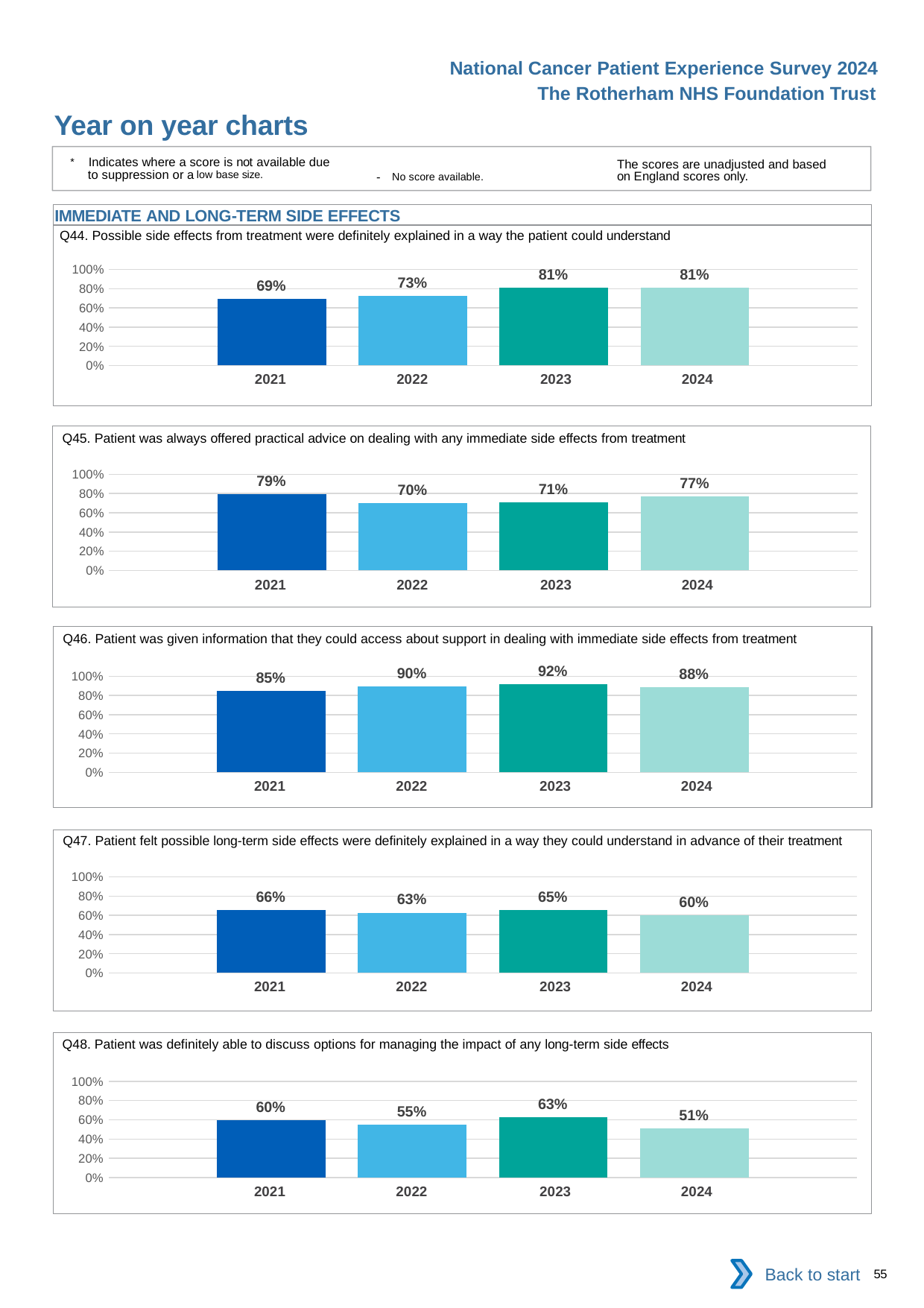
What is the section heading above the Q44 chart? IMMEDIATE AND LONG-TERM SIDE EFFECTS In the Q46 chart, is the value for 2024 greater or less than 80%? greater In the Q48 chart, is the value for 2023 larger or smaller than the value for 2022? larger In the Q45 chart, what is the difference between the 2021 and 2022 values? 9 percentage points What kind of chart is the Q45 chart? bar chart In the Q44 chart, how many years are plotted? 4 In the Q45 chart, which year has the highest value? 2021 In the Q47 chart, which year has the lowest value? 2024 In the Q46 chart, what is the difference between the 2023 and 2021 values? 7 percentage points In the Q44 chart, what is the value for 2022? 73% In the Q44 chart, do the values rise or fall from 2021 to 2023? rise In the Q48 chart, what is the value for 2024? 51%